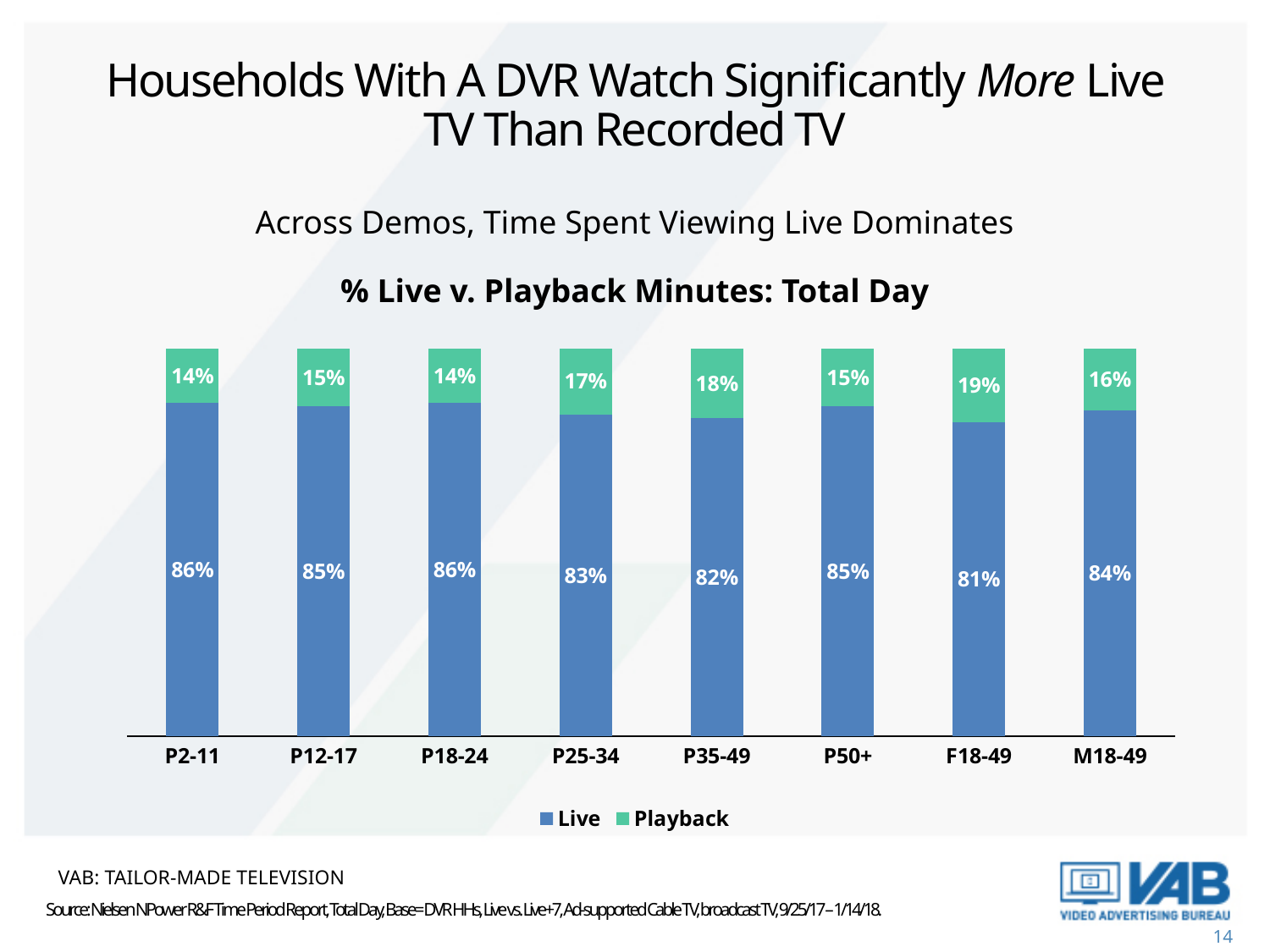
How many series does the legend list? 2 What is the total of the stacked bar for P12-17? 100% What is the title of the chart? % Live v. Playback Minutes: Total Day What is the Playback value for F18-49? 19% What kind of chart is shown? Stacked bar chart Which category has the lowest Live value? F18-49 Which is larger, the Playback value for P25-34 or the Playback value for P50+? P25-34 Which category has the highest Playback value? F18-49 What is the Live value for P25-34? 83% How many categories are shown on the x axis? 8 What is the Live value for M18-49? 84% What is the difference between the Live and Playback values for P35-49? 64%